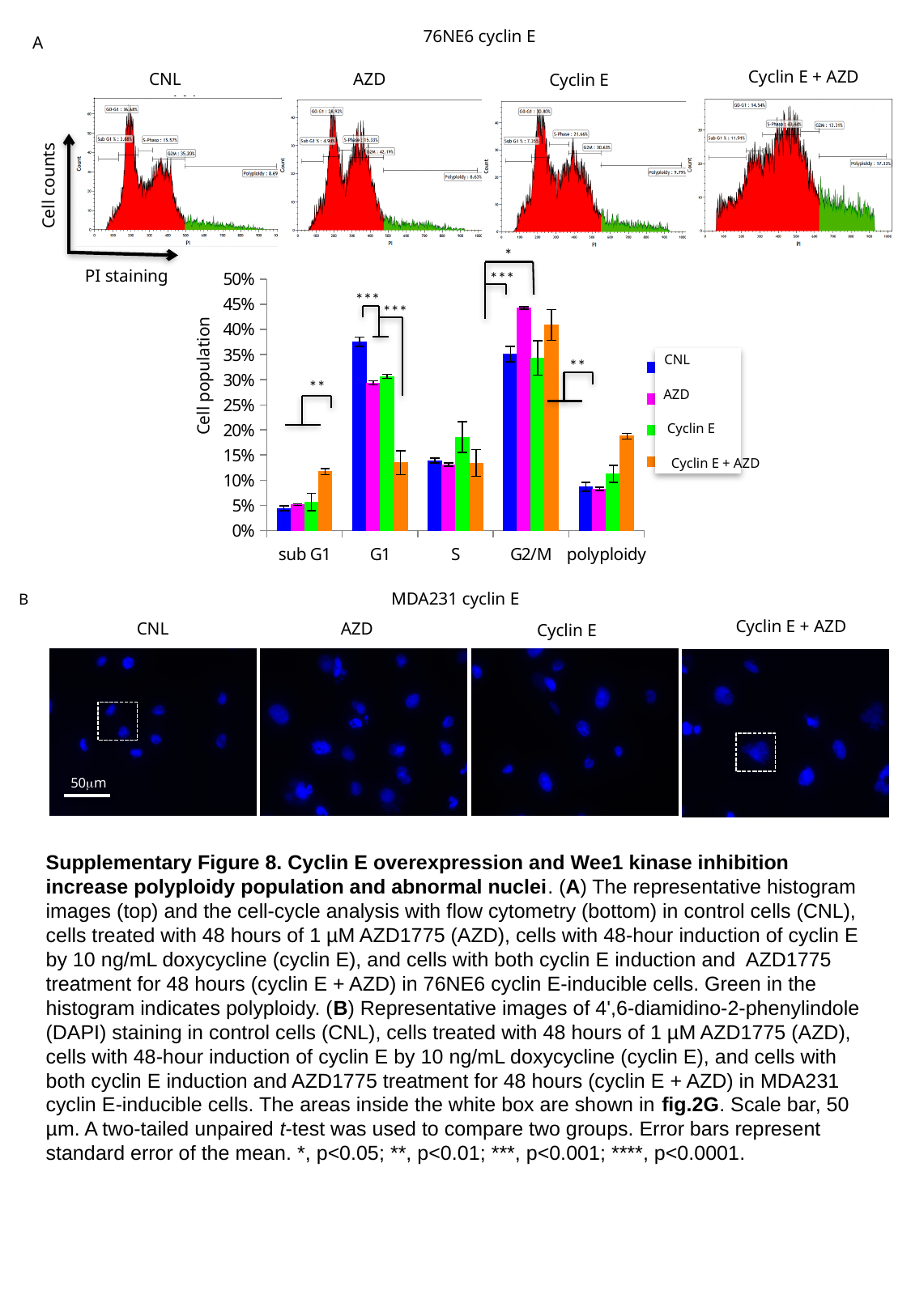
In the cell population bar chart, which series has the highest value in the G1 category? CNL What is the y-axis title of the bar chart in panel A? Cell population In the cell population bar chart, is the AZD value for G2/M greater or less than 40%? greater What kind of chart is the cell population chart in panel A? bar chart In the cell population bar chart, in which category is the Cyclin E + AZD bar the tallest? G2/M In the cell population bar chart, which series has the highest value in the G2/M category? AZD In the cell population bar chart, which series has the lowest value in the G1 category? Cyclin E + AZD In the cell population bar chart, which is larger in the polyploidy category: CNL or Cyclin E + AZD? Cyclin E + AZD In the cell population bar chart, is the CNL value for G1 greater or less than 35%? greater How many cell-cycle categories are shown on the x axis of the cell population bar chart? 5 In the cell population bar chart, is the Cyclin E + AZD value for sub G1 greater or less than 10%? greater How many series does the legend of the cell population bar chart list? 4